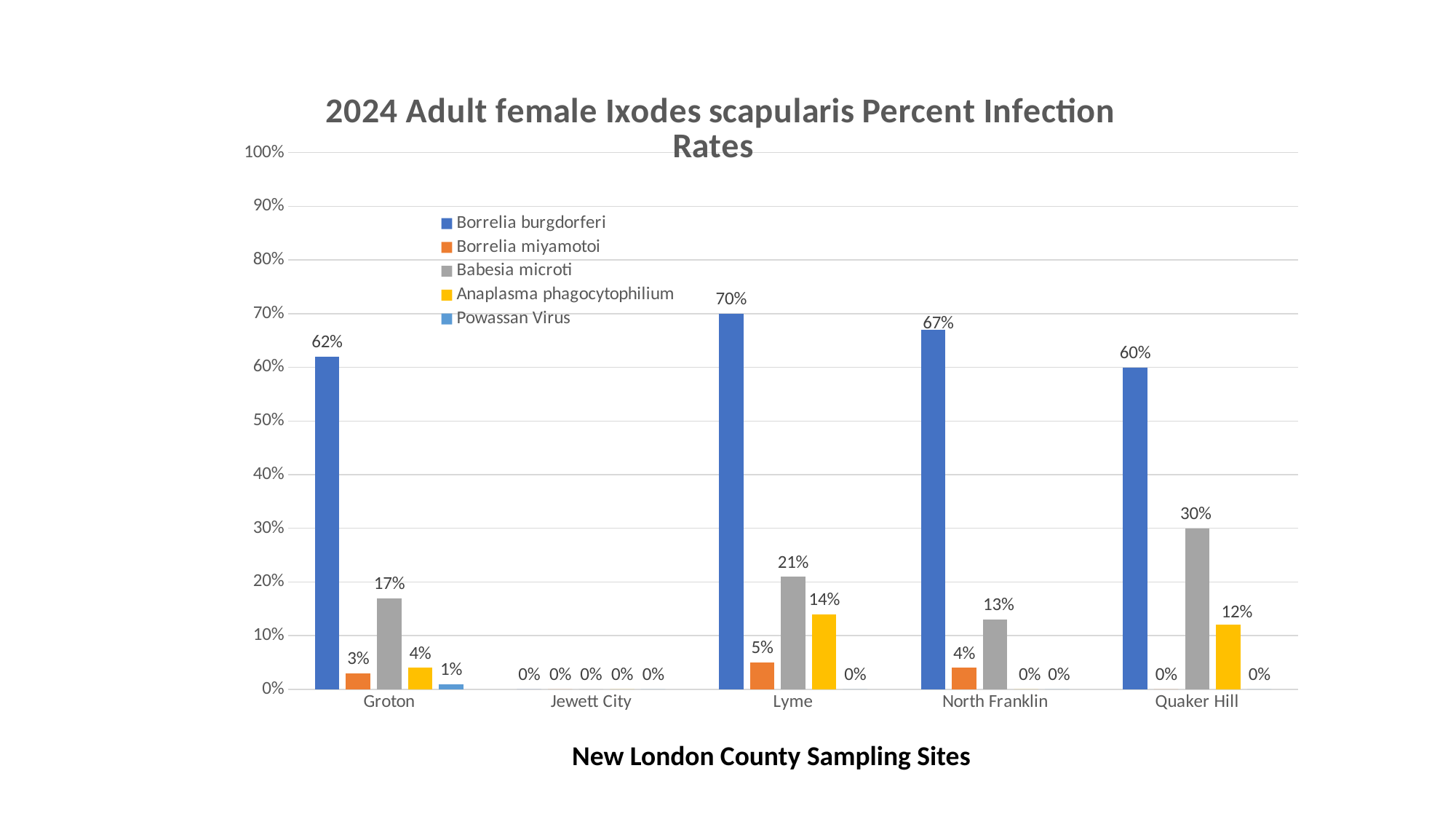
Which sampling site has the highest Borrelia burgdorferi infection rate? Lyme What is the difference between the Borrelia burgdorferi rates at Lyme and Quaker Hill? 10% Which sampling site has the lowest Babesia microti infection rate? Jewett City What kind of chart is shown on the slide? Bar chart How many series does the legend list? 5 What is the x-axis label of the chart? New London County Sampling Sites What is the Anaplasma phagocytophilium infection rate at North Franklin? 0% What is the Powassan Virus infection rate at Groton? 1% What is the Babesia microti infection rate at Quaker Hill? 30% What is the Borrelia burgdorferi infection rate at Lyme? 70% Which is larger, the Babesia microti rate at Groton or at Lyme? Lyme How many sampling sites are shown on the x axis? 5